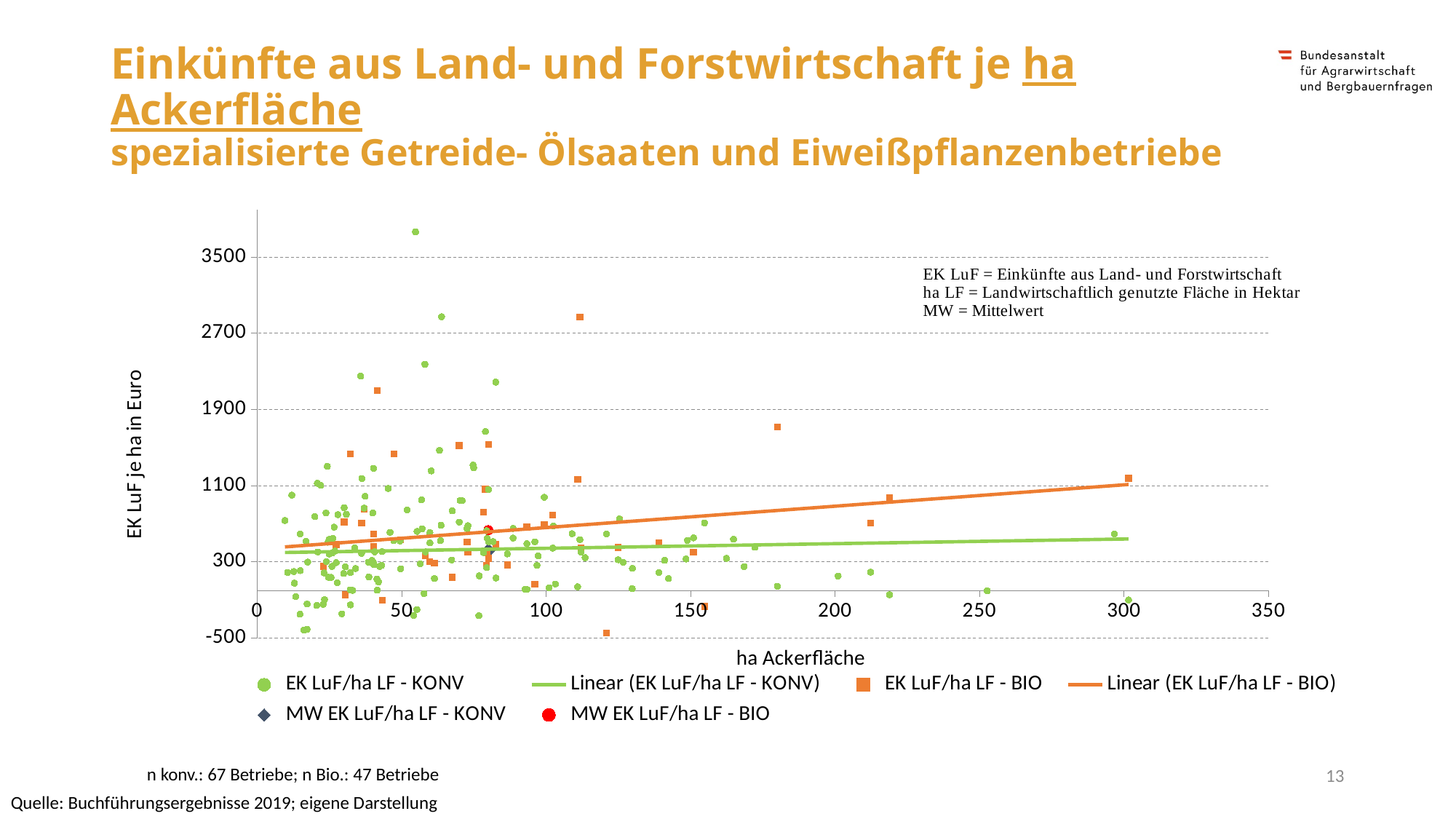
How many entries does the chart legend list? 6 What is the label of the y axis? EK LuF je ha in Euro How many conventional farms (n konv.) are included in the chart according to the slide? 67 Betriebe Which series contains the single highest point on the chart, EK LuF/ha LF - KONV or EK LuF/ha LF - BIO? EK LuF/ha LF - KONV Does the linear trend line for EK LuF/ha LF - BIO rise or fall as ha Ackerfläche increases? rise Which linear trend line is steeper, the one for KONV or the one for BIO? BIO Which mean marker is higher, MW EK LuF/ha LF - KONV or MW EK LuF/ha LF - BIO? MW EK LuF/ha LF - BIO What kind of chart is shown on the slide? scatter chart What is the label of the x axis? ha Ackerfläche Is the highest KONV point greater or less than 3500? greater Is the value of the MW EK LuF/ha LF - BIO marker greater or less than 300? greater